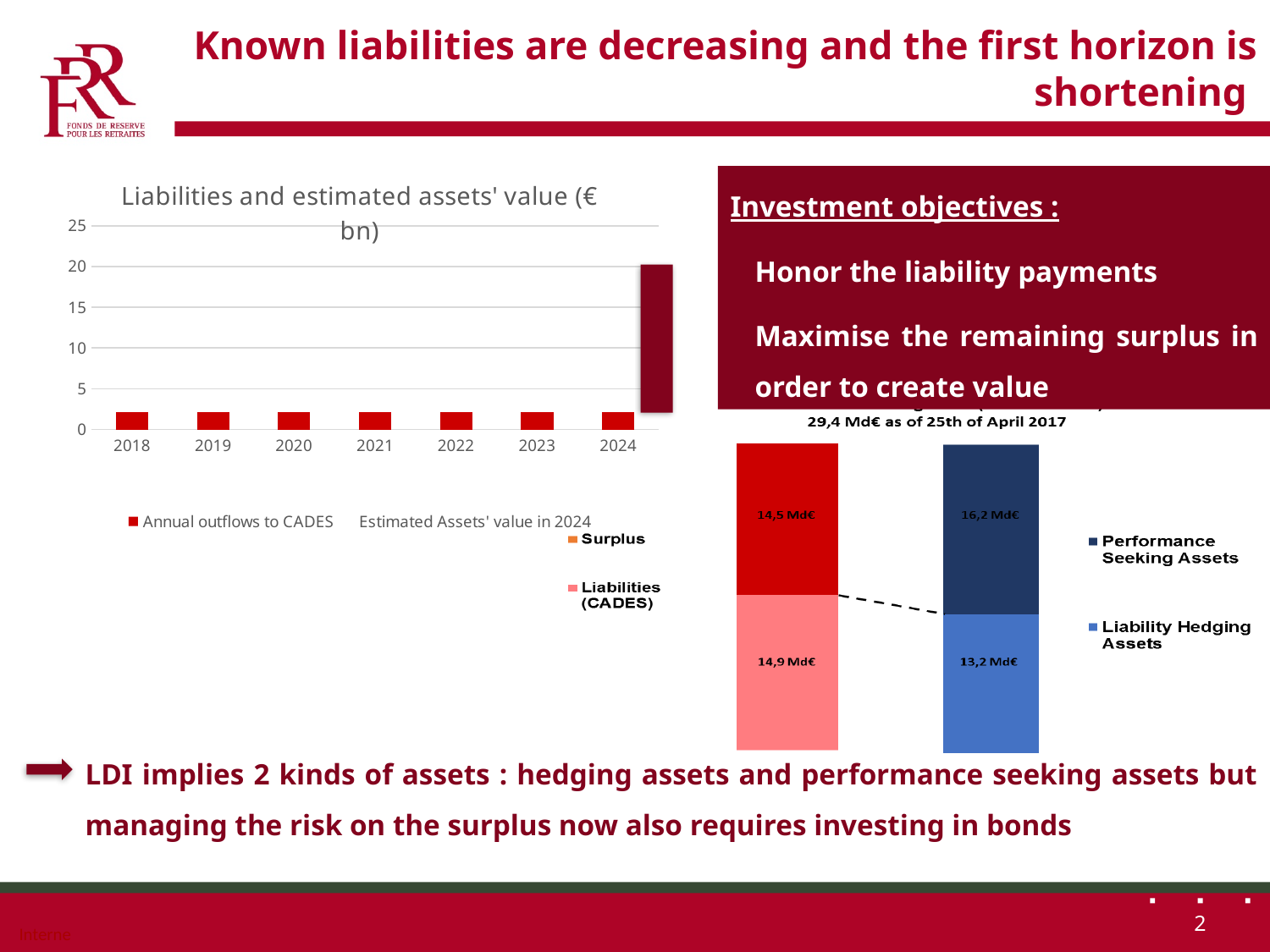
In the stacked bar chart on the right (29,4 Md€ as of 25th of April 2017), which is larger: Performance Seeking Assets or Liability Hedging Assets? Performance Seeking Assets In the chart titled "Liabilities and estimated assets' value (€ bn)", how many series does the legend list? 2 In the stacked bar chart on the right (29,4 Md€ as of 25th of April 2017), what is the value of Liabilities (CADES)? 14,9 Md€ In the chart titled "Liabilities and estimated assets' value (€ bn)", is the Estimated Assets' value in 2024 greater or less than 15? greater In the stacked bar chart on the right (29,4 Md€ as of 25th of April 2017), what is the value of Surplus? 14,5 Md€ In the stacked bar chart on the right (29,4 Md€ as of 25th of April 2017), what is the difference between Performance Seeking Assets and Liability Hedging Assets? 3,0 Md€ In the chart titled "Liabilities and estimated assets' value (€ bn)", which year has the highest bar? 2024 In the chart titled "Liabilities and estimated assets' value (€ bn)", how many years are shown on the x axis? 7 What kind of chart is the one titled "Liabilities and estimated assets' value (€ bn)"? Bar chart In the stacked bar chart on the right (29,4 Md€ as of 25th of April 2017), what is the total of the bar made up of Surplus and Liabilities (CADES)? 29,4 Md€ In the chart titled "Liabilities and estimated assets' value (€ bn)", is the value for Annual outflows to CADES in 2018 greater or less than 5? less In the stacked bar chart on the right (29,4 Md€ as of 25th of April 2017), what is the value of Performance Seeking Assets? 16,2 Md€